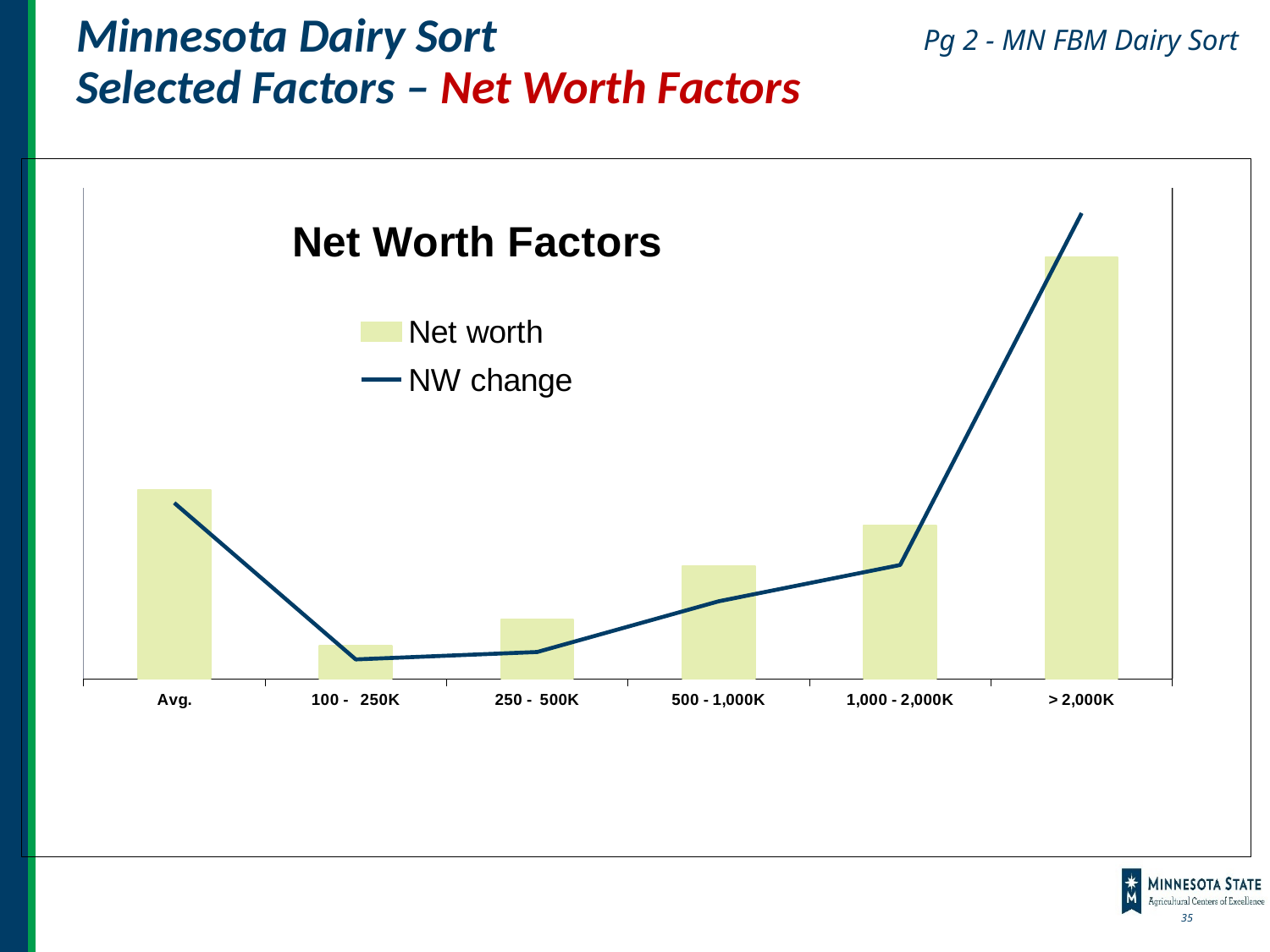
Do the Net worth bars rise or fall from 100 - 250K to > 2,000K? Rise What are the two series named in the legend? Net worth and NW change How many series does the chart legend list? 2 Which has the larger Net worth bar, Avg. or 1,000 - 2,000K? Avg. Does the NW change line rise or fall from 250 - 500K to > 2,000K? Rise What kind of chart is this? Combined bar and line chart Which category has the highest point on the NW change line? > 2,000K What is the title of the chart? Net Worth Factors How many categories are shown on the x axis? 6 Which category has the lowest Net worth bar? 100 - 250K Which category has the highest Net worth bar? > 2,000K Which has the larger Net worth bar, 250 - 500K or 500 - 1,000K? 500 - 1,000K